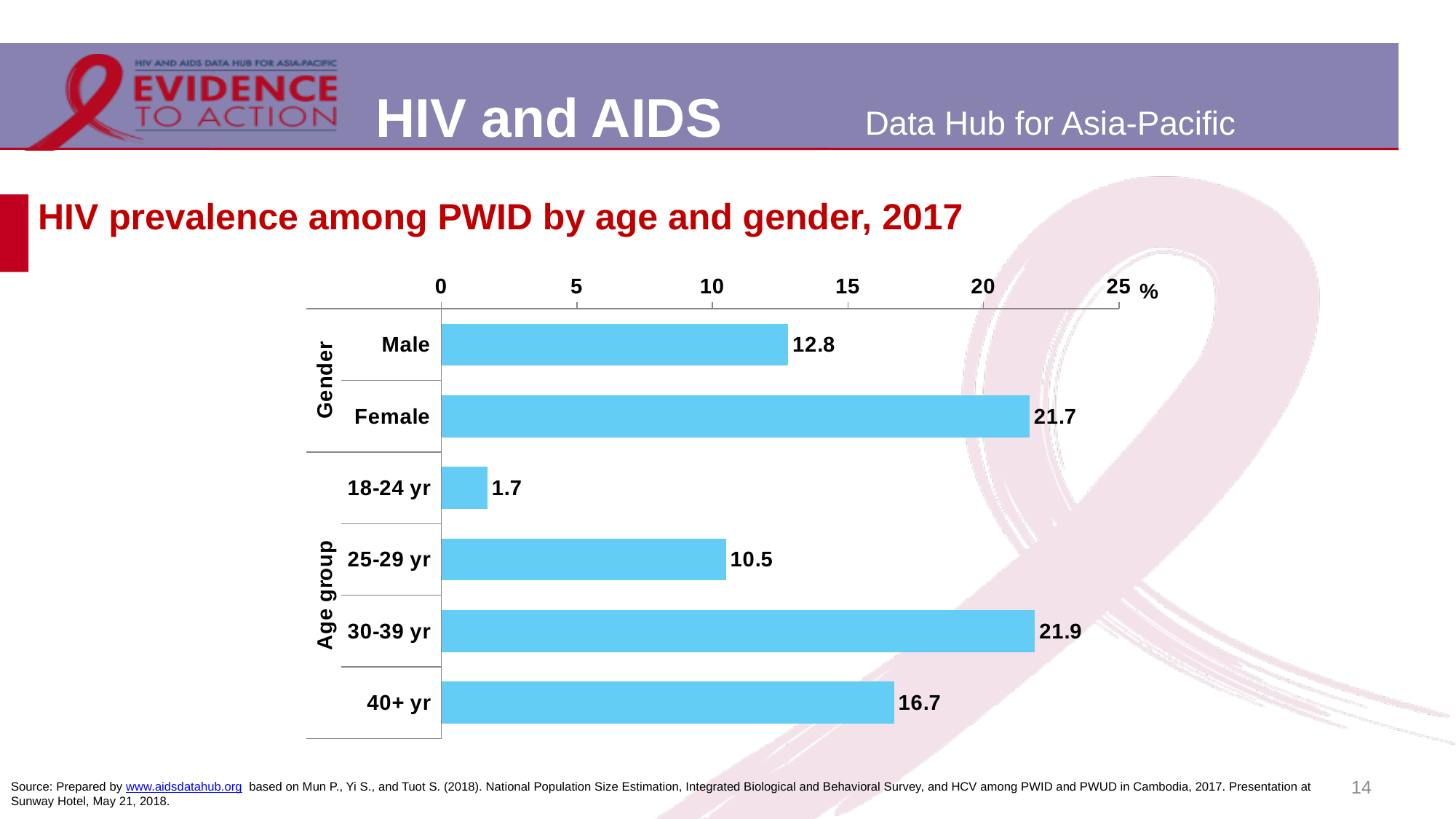
Which age group has the highest HIV prevalence? 30-39 yr How many bars are plotted in the chart? 6 Which has a higher HIV prevalence, the 25-29 yr group or the 40+ yr group? 40+ yr What is the difference in HIV prevalence between female and male PWID? 8.9 What kind of chart is shown on the slide? Bar chart What is the HIV prevalence among female PWID? 21.7 What is the HIV prevalence among male PWID? 12.8 Is the value for the 30-39 yr group greater or less than 20? greater What is the title of the chart? HIV prevalence among PWID by age and gender, 2017 What is the HIV prevalence for the 18-24 yr age group? 1.7 What is the HIV prevalence for the 40+ yr age group? 16.7 Which age group has the lowest HIV prevalence? 18-24 yr